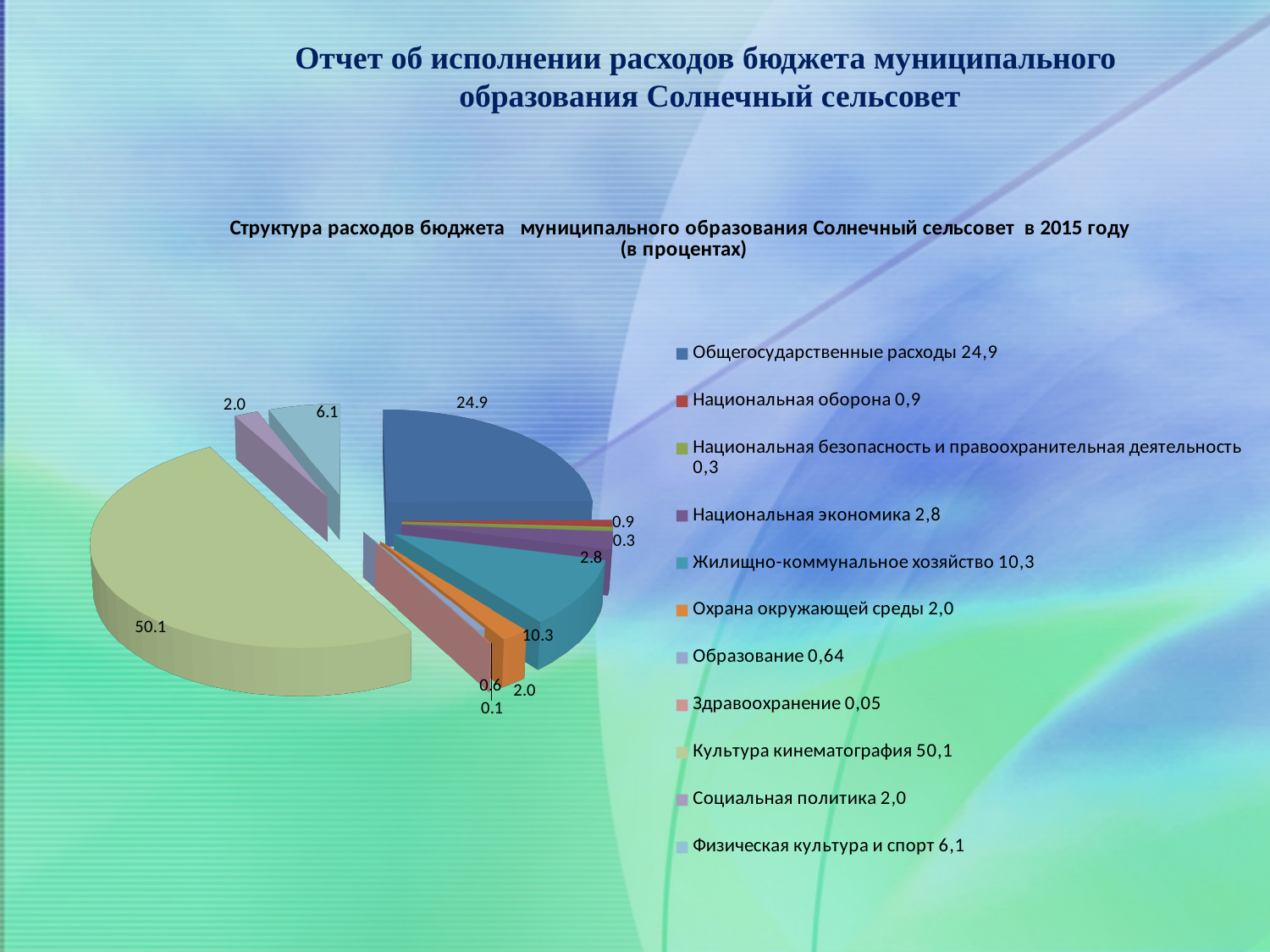
What year does the chart title say the budget expenditure structure refers to? 2015 What is the difference between the values for Культура кинематография and Общегосударственные расходы? 25.2 Which category has the largest share of the pie chart? Культура кинематография What is the difference between the values for Жилищно-коммунальное хозяйство and Физическая культура и спорт? 4.2 What kind of chart is shown on the slide? Pie chart What is the value shown for Общегосударственные расходы? 24.9 What is the value shown for Физическая культура и спорт? 6.1 How many categories does the pie chart show? 11 Which category has the smallest share of the pie chart? Здравоохранение What is the value shown for Жилищно-коммунальное хозяйство? 10.3 What is the value shown for Национальная экономика? 2.8 Which is larger: Общегосударственные расходы or Жилищно-коммунальное хозяйство? Общегосударственные расходы